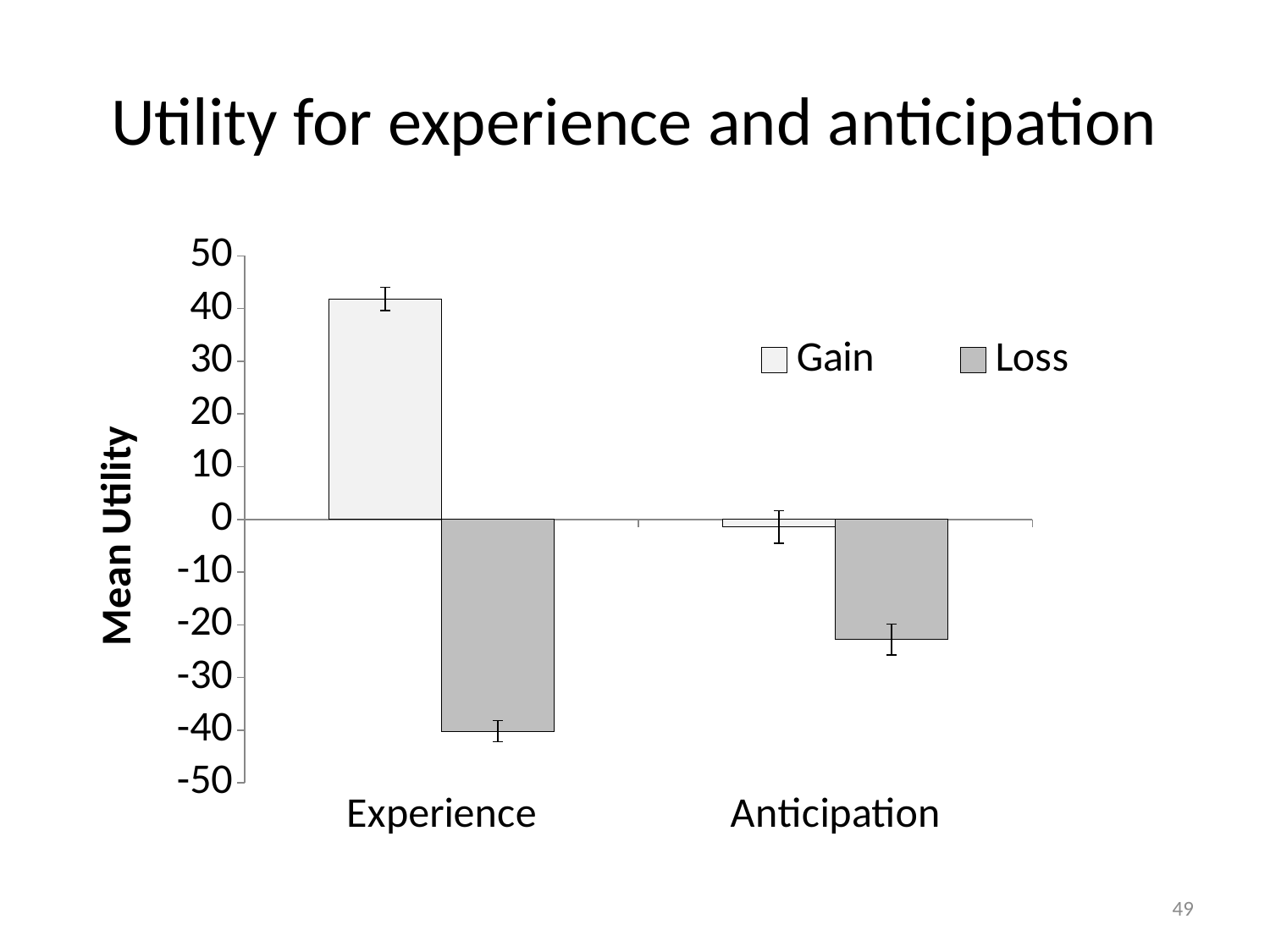
Which is larger, the Gain value for Experience or the Gain value for Anticipation? Experience Is the Loss value for Experience greater or less than -30? less What kind of chart is shown on the slide? bar chart Which series are listed in the legend? Gain and Loss Is the Loss value for Anticipation greater or less than -10? less How many series does the legend list? 2 Is the Gain value for Anticipation greater or less than -10? greater Which bar has the lowest mean utility? Loss for Experience What is the label of the vertical axis? Mean Utility How many categories are shown on the x axis? 2 Which bar has the highest mean utility? Gain for Experience